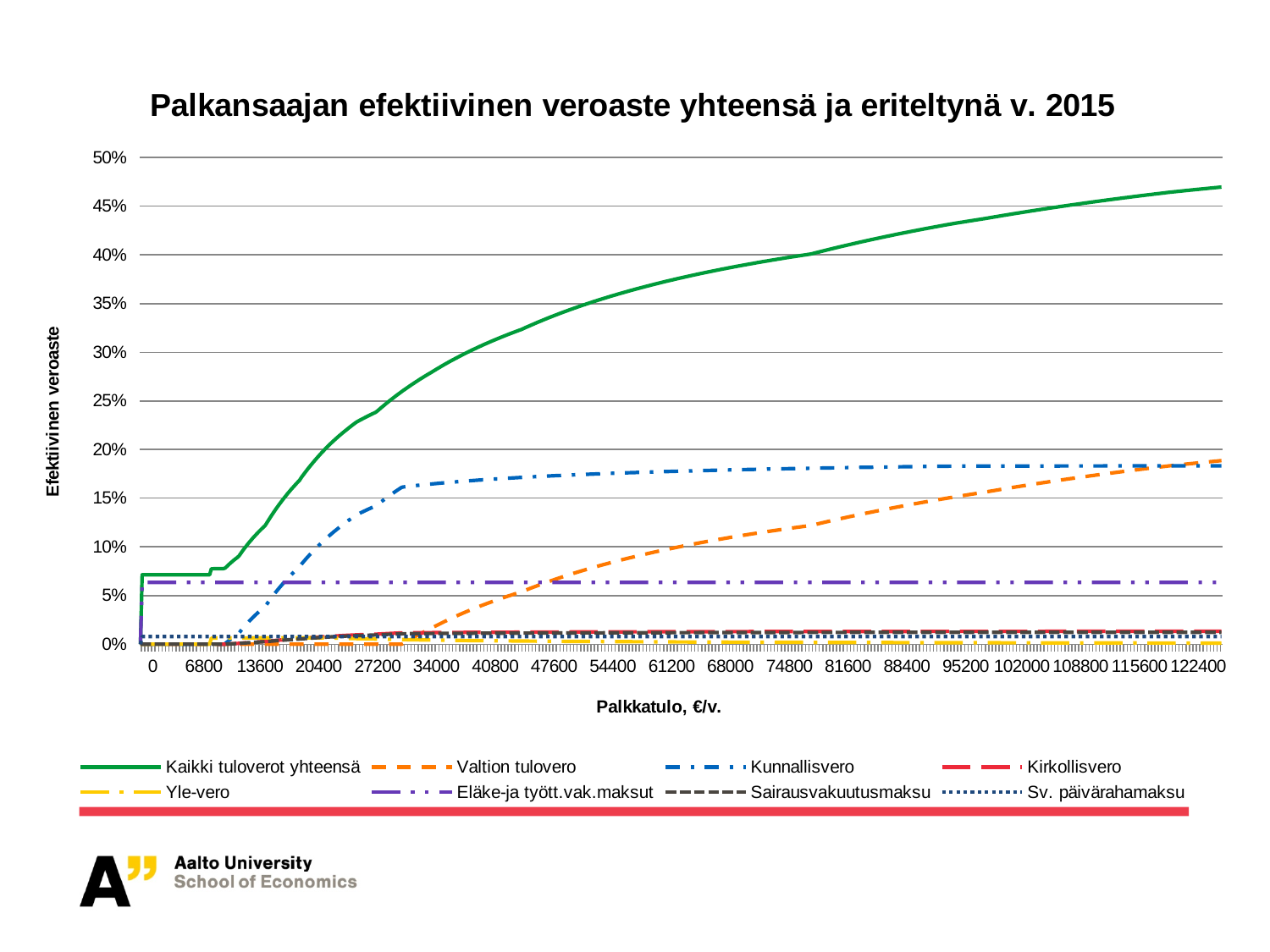
Is the value of Kaikki tuloverot yhteensä at 122400 greater or less than 45%? greater Does the Kaikki tuloverot yhteensä line rise or fall as Palkkatulo increases? rise Is the value of Kunnallisvero at 122400 greater or less than 15%? greater What kind of chart is shown on the slide? line chart Is the value of Eläke-ja tyött.vak.maksut at 68000 greater or less than 10%? less What is the title of the chart? Palkansaajan efektiivinen veroaste yhteensä ja eriteltynä v. 2015 At 40800, which is larger: Kunnallisvero or Valtion tulovero? Kunnallisvero Which series has the highest value at 122400? Kaikki tuloverot yhteensä What is the label of the x axis? Palkkatulo, €/v. Which series has the lowest value at 122400? Yle-vero How many series does the legend list? 8